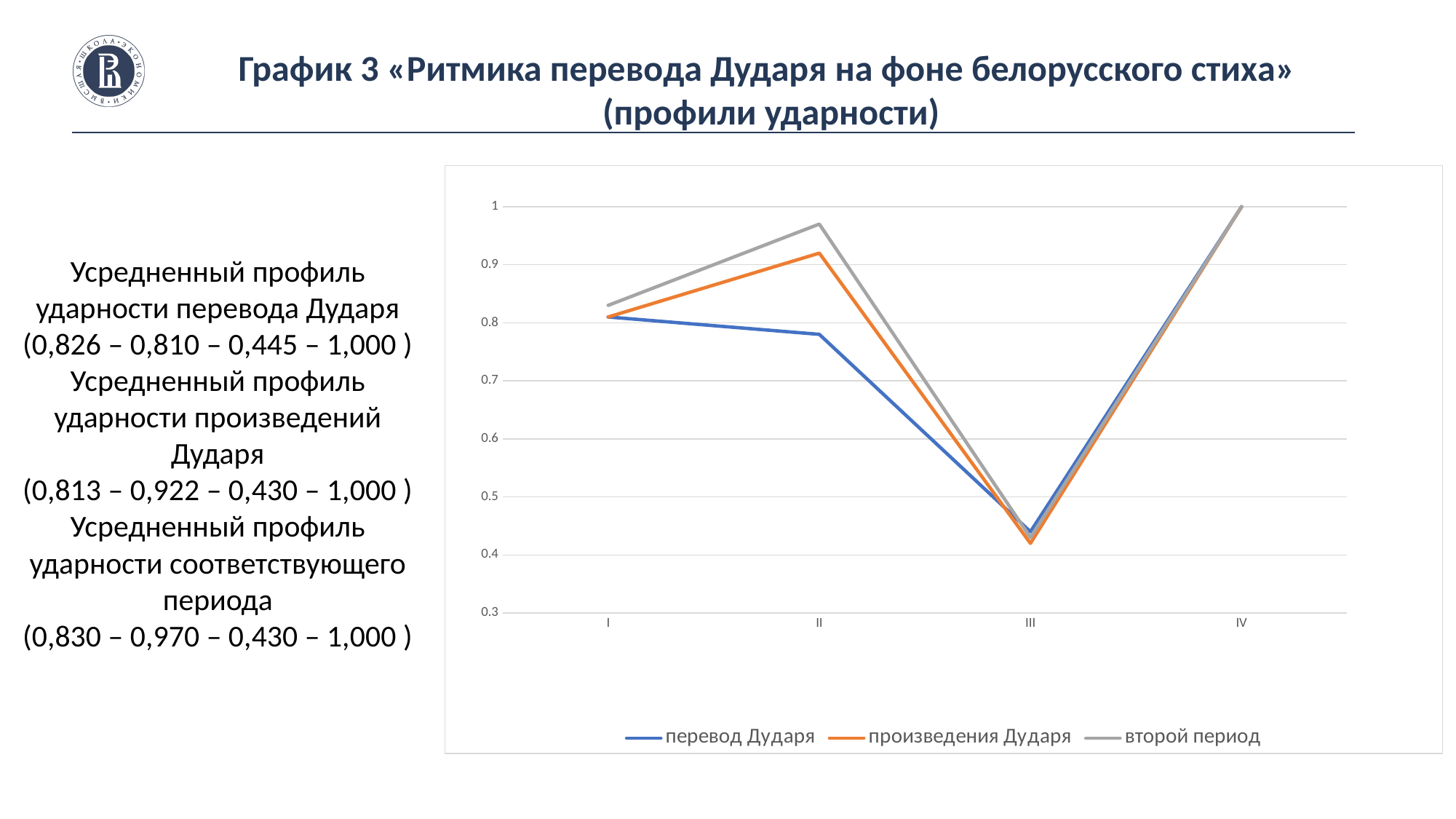
Is the value for 'второй период' at position II greater or less than 0.9? greater How many series does the chart legend list? 3 How many positions are marked along the x axis of the chart? 4 At position II, which series has the higher value: 'второй период' or 'перевод Дударя'? второй период What kind of chart is shown on the slide? line chart At which x-axis position does the series 'второй период' have its lowest value? III What value does the series 'второй период' reach at position IV? 1 Is the value for 'произведения Дударя' at position III greater or less than 0.5? less Does the series 'перевод Дударя' rise or fall from position II to position III? fall At which x-axis position does the series 'перевод Дударя' have its highest value? IV What colour is the line for 'произведения Дударя' in the chart? orange Is the value for 'перевод Дударя' at position II greater or less than 0.8? less